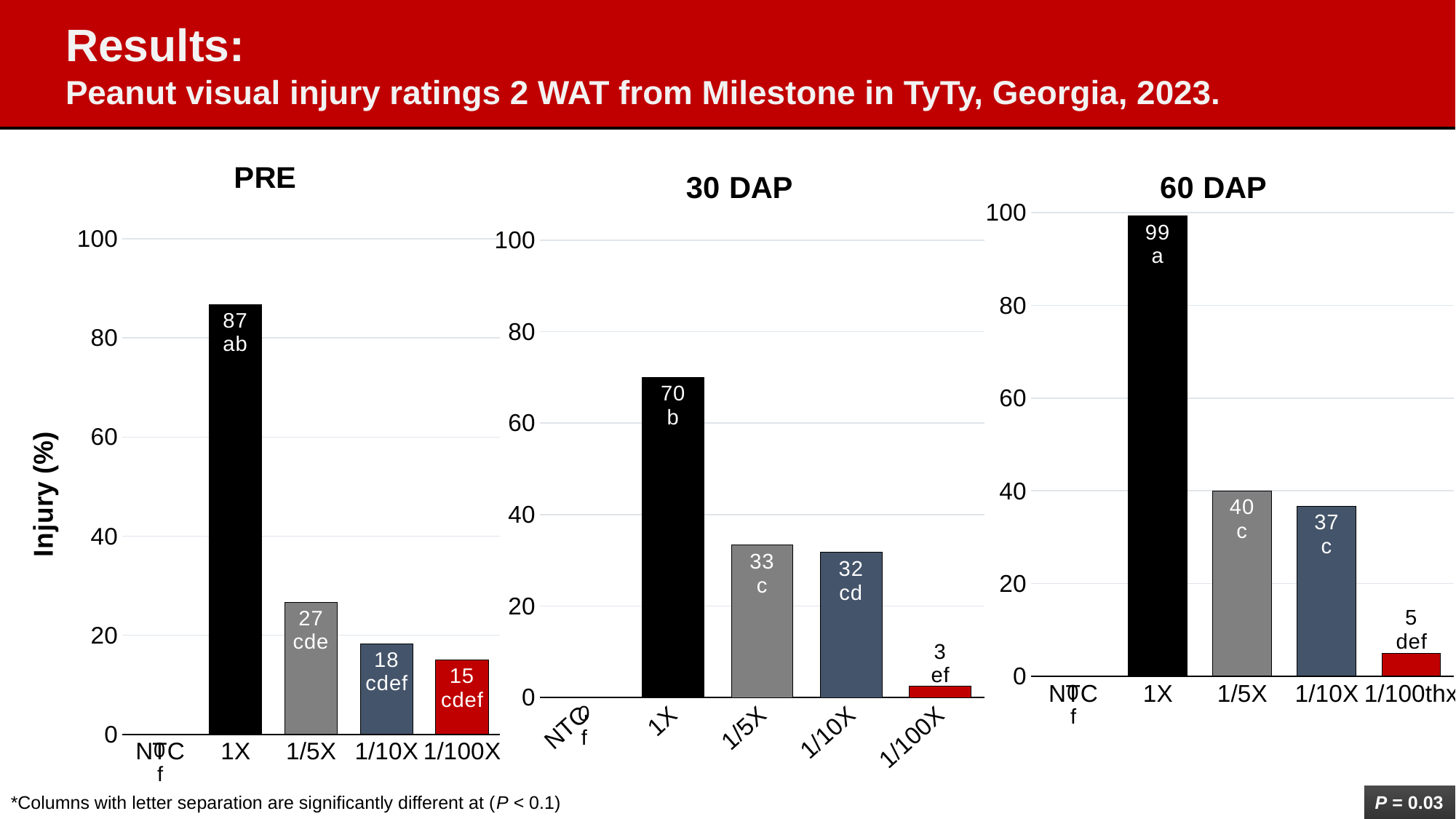
In the 60 DAP chart, what is the injury value for the 1/100X treatment? 5 In the PRE chart, is the injury value for 1/10X greater or less than 20? less What is the y-axis label shared by the charts on the slide? Injury (%) In the 60 DAP chart, which treatment has the highest injury value? 1X How many treatment categories are shown on the x axis of the 30 DAP chart? 5 In the 30 DAP chart, what is the injury value for the 1/5X treatment? 33 What kind of chart is the 60 DAP chart? bar chart In the 30 DAP chart, which is larger, the injury value for 1X or for 1/10X? 1X In the 60 DAP chart, what is the difference between the injury values for 1/5X and 1/10X? 3 In the 30 DAP chart, which treatment has the lowest non-zero injury value? 1/100X In the PRE chart, what is the injury value for the 1X treatment? 87 In the PRE chart, what is the difference between the injury values for 1X and 1/5X? 60